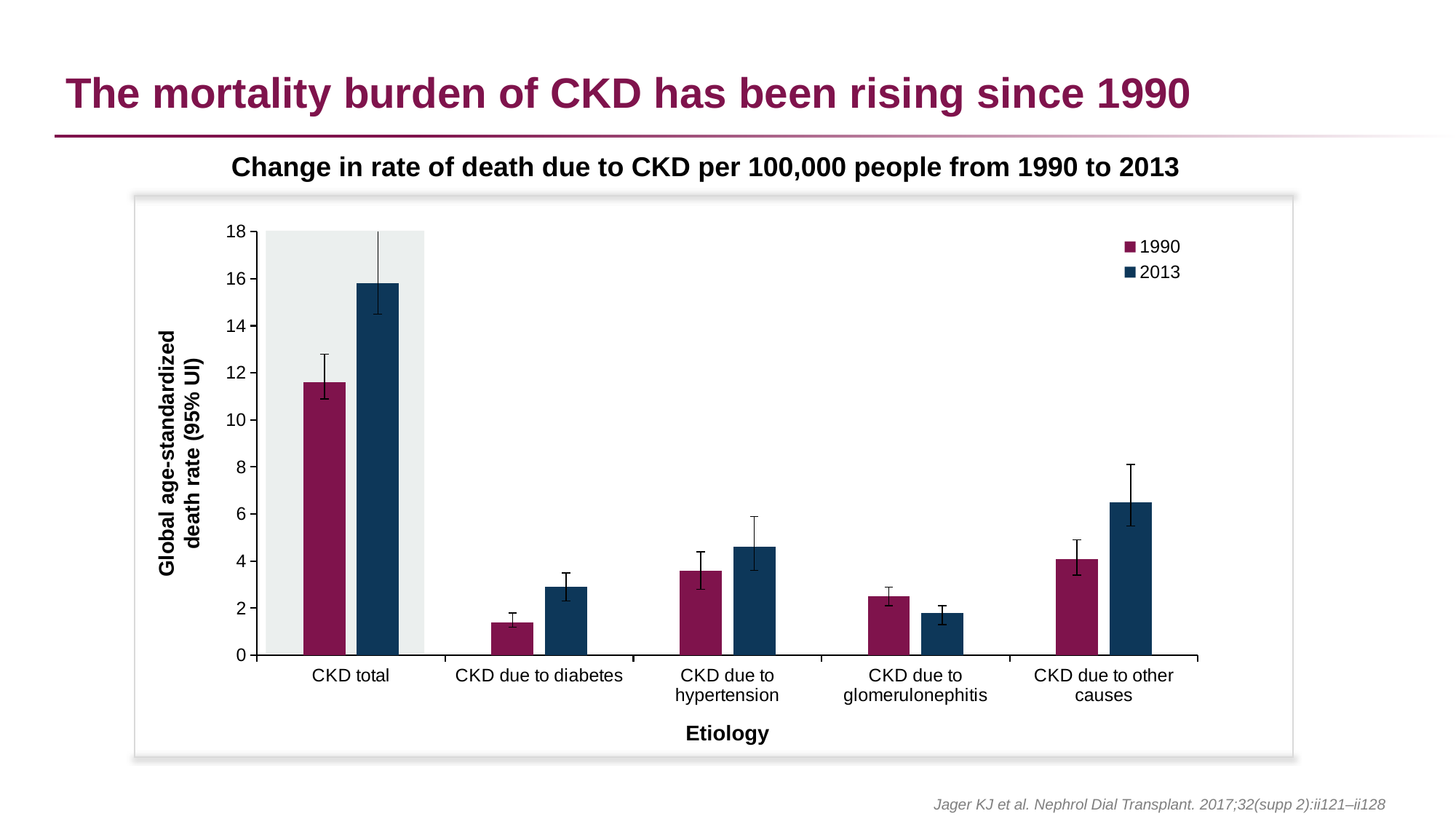
How many series does the legend list? 2 What is the title of the x axis? Etiology How many etiology categories are shown on the x axis? 5 Is the 1990 value for CKD due to diabetes greater or less than 2? less What kind of chart is shown on the slide? Bar chart Which category has the lowest 1990 value? CKD due to diabetes Is the 1990 value for CKD total greater or less than 10? greater For CKD due to other causes, which year has the larger value, 1990 or 2013? 2013 Which category has the highest 2013 value? CKD total Is the 2013 value for CKD due to hypertension greater or less than 4? greater For CKD due to glomerulonephitis, which year has the larger value, 1990 or 2013? 1990